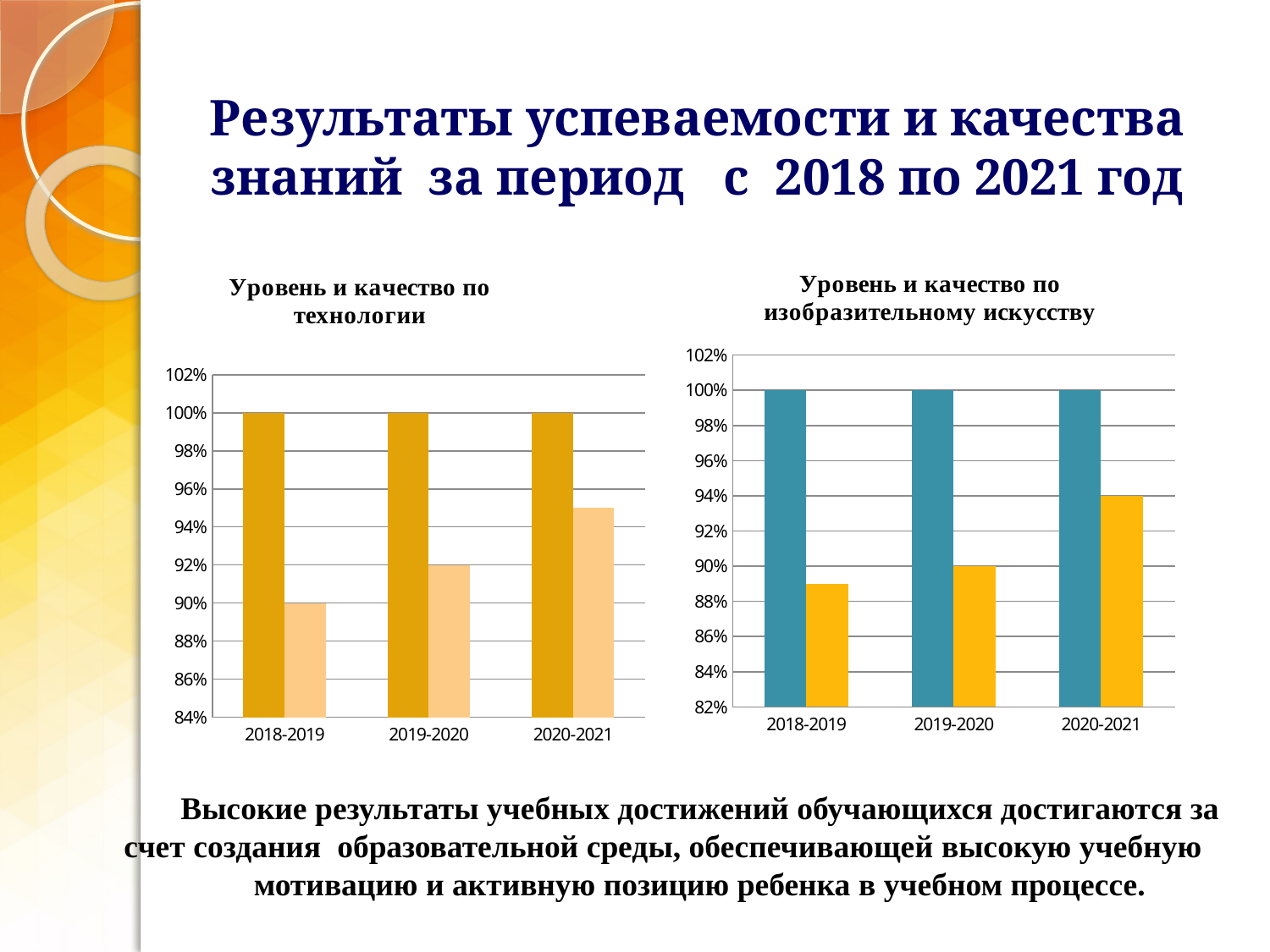
In the chart titled "Уровень и качество по технологии", what is the value of the light orange bar for 2019-2020? 92% In the chart titled "Уровень и качество по технологии", what is the difference between the dark gold bar and the light orange bar for 2019-2020? 8% In the chart titled "Уровень и качество по технологии", do the light orange bars rise or fall from 2018-2019 to 2020-2021? rise In the chart titled "Уровень и качество по изобразительному искусству", what is the value of the yellow bar for 2020-2021? 94% In the chart titled "Уровень и качество по технологии", how many year categories are shown on the x axis? 3 In the chart titled "Уровень и качество по изобразительному искусству", for which year is the yellow bar lowest? 2018-2019 In the chart titled "Уровень и качество по технологии", for which year is the light orange bar highest? 2020-2021 In the chart titled "Уровень и качество по технологии", what is the value of the dark gold bar for 2018-2019? 100% In the chart titled "Уровень и качество по изобразительному искусству", is the yellow bar for 2018-2019 greater or less than 90%? less What type of chart is the chart titled "Уровень и качество по технологии"? bar chart In the chart titled "Уровень и качество по изобразительному искусству", what is the value of the yellow bar for 2019-2020? 90% In the chart titled "Уровень и качество по технологии", is the light orange bar for 2020-2021 greater or less than 94%? greater